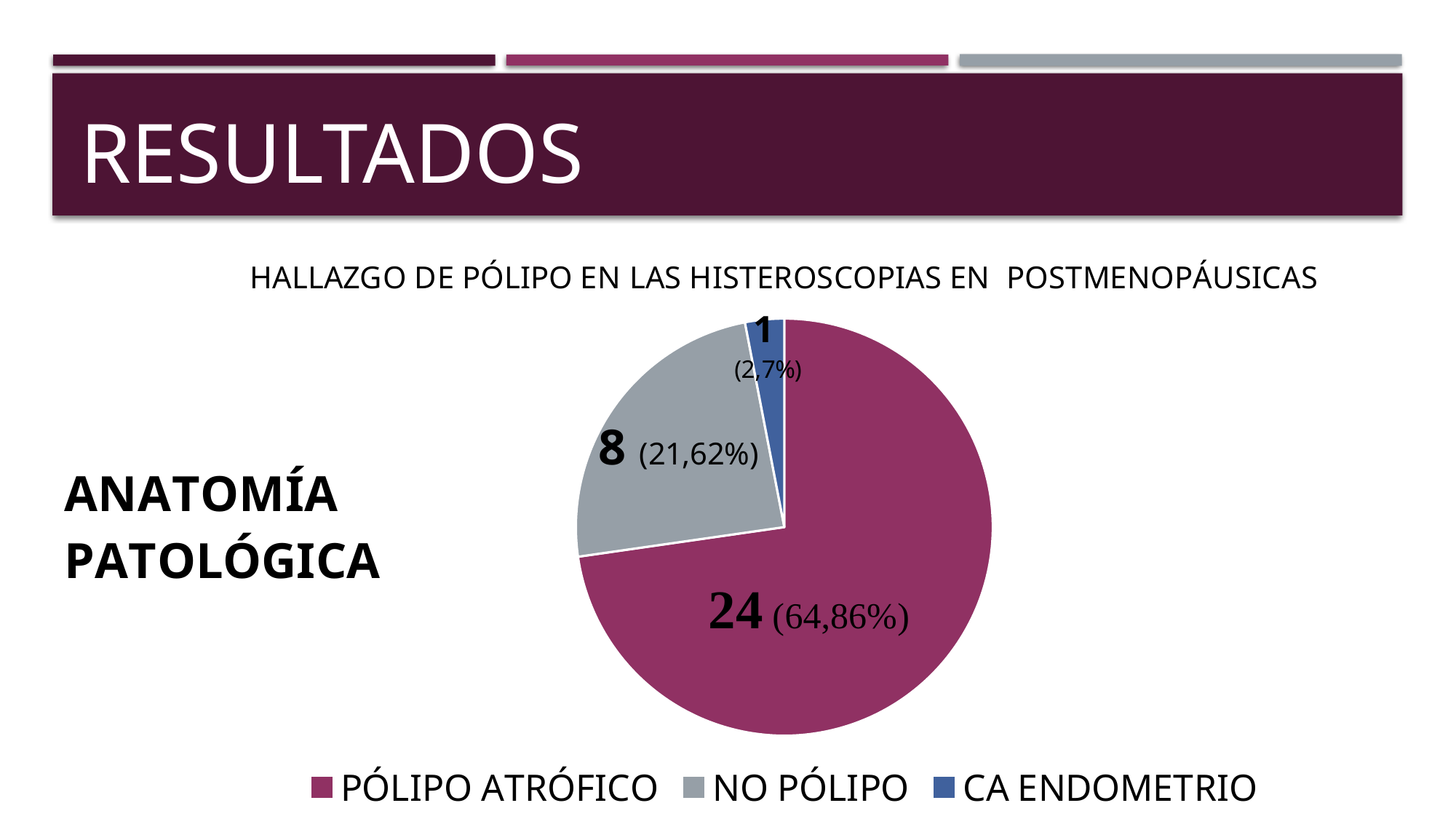
What is the difference between the counts for PÓLIPO ATRÓFICO and NO PÓLIPO? 16 What kind of chart is shown on the slide? Pie chart What share of the pie does NO PÓLIPO represent? 21,62% How many slices does the pie chart have? 3 How many entries does the legend list? 3 What is the count for PÓLIPO ATRÓFICO? 24 Which category has the smallest slice? CA ENDOMETRIO What is the count for NO PÓLIPO? 8 What is the count for CA ENDOMETRIO? 1 Which category has the largest slice? PÓLIPO ATRÓFICO What share of the pie does PÓLIPO ATRÓFICO represent? 64,86% What is the title of the chart? HALLAZGO DE PÓLIPO EN LAS HISTEROSCOPIAS EN POSTMENOPÁUSICAS